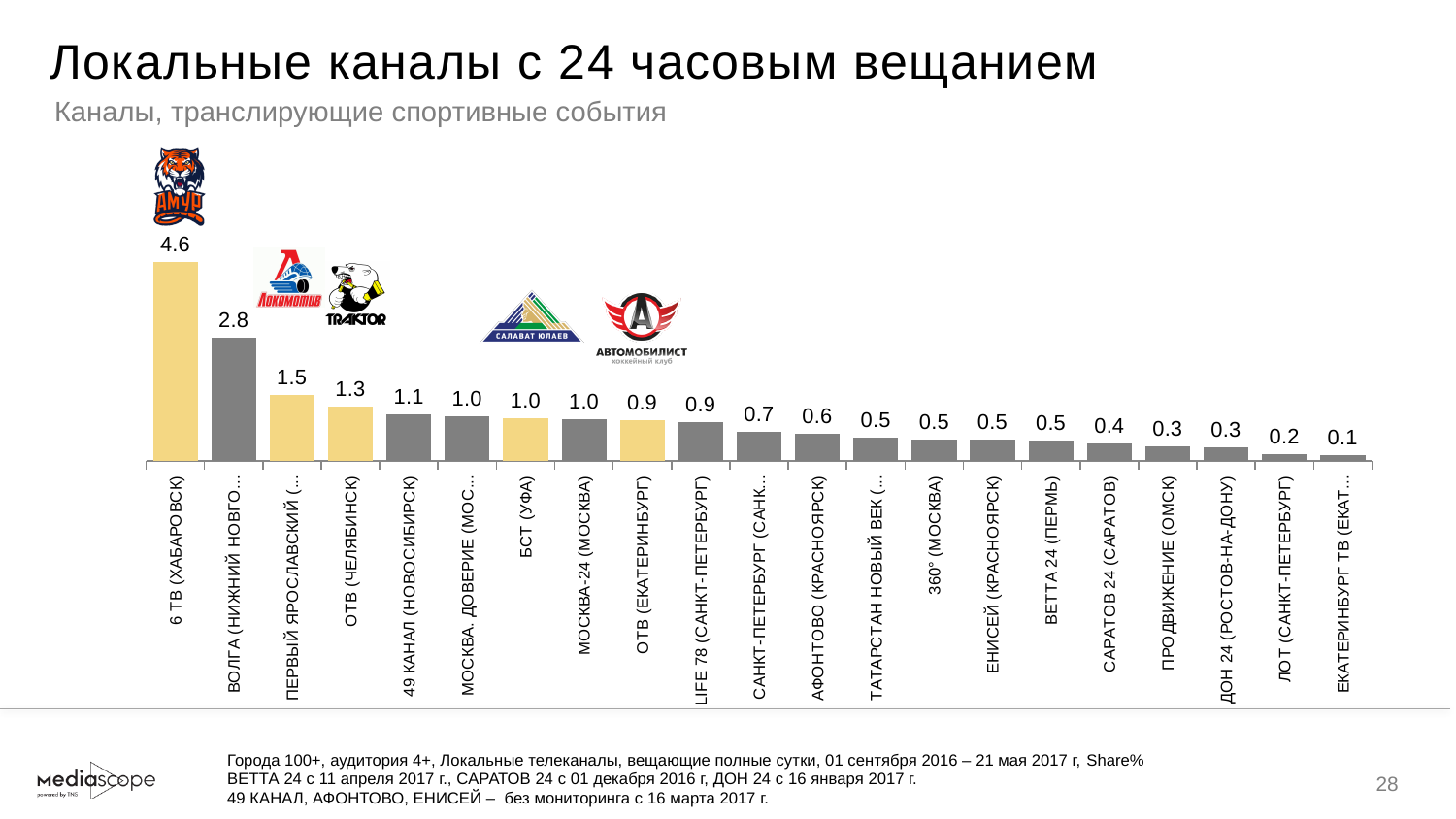
Which channel has the highest value? 6 ТВ (ХАБАРОВСК) What kind of chart is shown on the slide? Bar chart What is the value for ЛОТ (САНКТ-ПЕТЕРБУРГ)? 0.2 What is the value for ВЕТТА 24 (ПЕРМЬ)? 0.5 Do the values rise or fall from left to right along the x axis? Fall What is the difference between the values for 6 ТВ (ХАБАРОВСК) and ОТВ (ЧЕЛЯБИНСК)? 3.3 What is the lowest value shown in the chart? 0.1 Which is larger, the value for МОСКВА-24 (МОСКВА) or the value for АФОНТОВО (КРАСНОЯРСК)? МОСКВА-24 (МОСКВА) What is the value for 6 ТВ (ХАБАРОВСК)? 4.6 What is the value for ОТВ (ЧЕЛЯБИНСК)? 1.3 What is the value for БСТ (УФА)? 1.0 How many channels are shown in the chart? 21